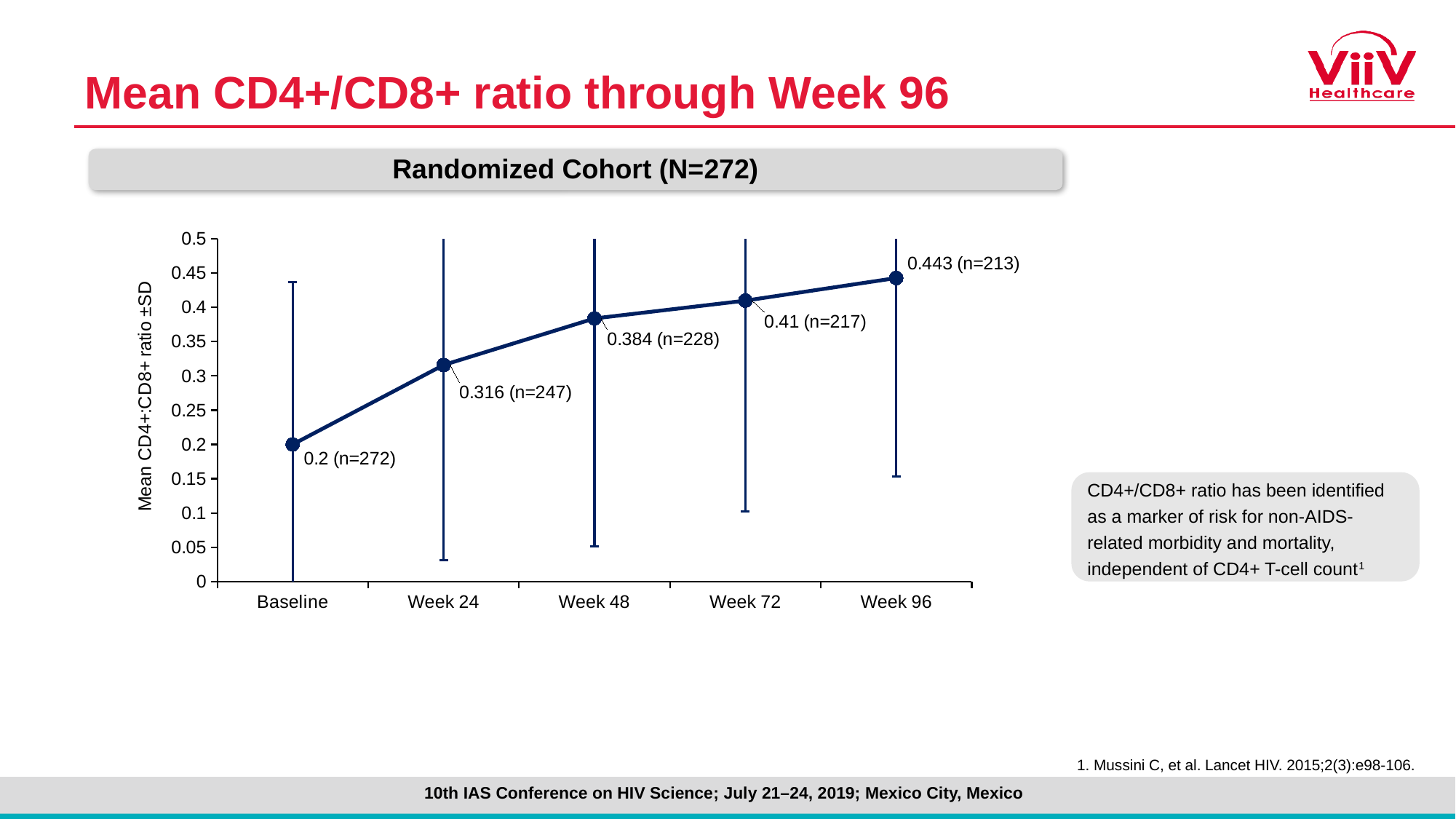
Does the mean CD4+:CD8+ ratio rise or fall from Baseline to Week 96? Rise What is the label of the y axis? Mean CD4+:CD8+ ratio ±SD What is the mean CD4+:CD8+ ratio at Week 48? 0.384 How many time points are plotted on the x axis? 5 Which is larger, the mean ratio at Week 72 or at Week 24? Week 72 What kind of chart is shown on the slide? Line chart At which time point is the mean CD4+:CD8+ ratio lowest? Baseline How many participants (n) contributed to the Week 24 value? 247 What is the mean CD4+:CD8+ ratio at Week 96? 0.443 What is the mean CD4+:CD8+ ratio at Baseline? 0.2 What is the difference between the mean ratio at Week 96 and at Baseline? 0.243 At which time point is the mean CD4+:CD8+ ratio highest? Week 96